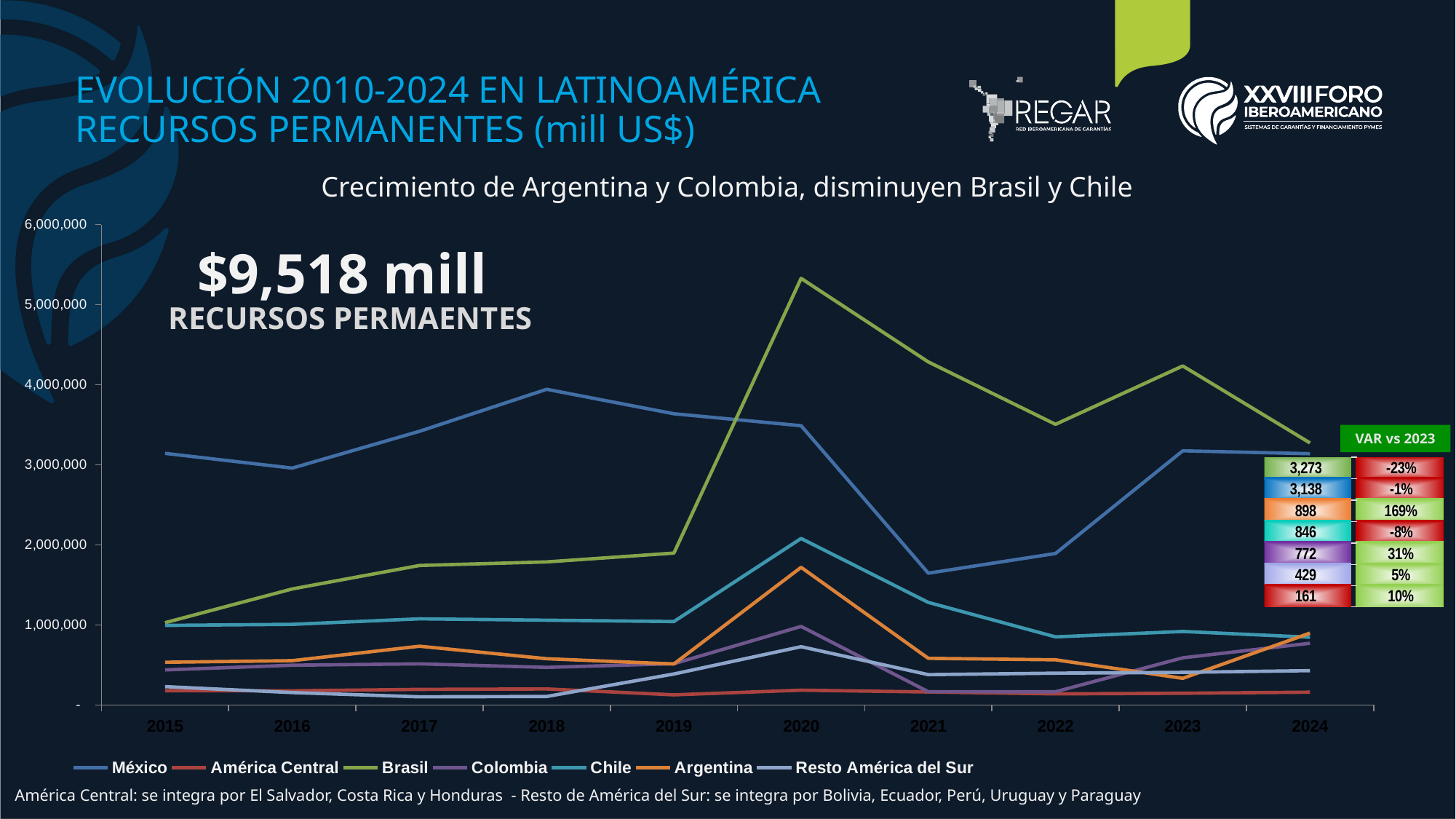
Which series has the lowest value in 2024? América Central Does the Brasil line rise or fall from 2015 to 2020? rise How many years are shown along the x axis? 10 How many series does the legend list? 7 What kind of chart is shown on the slide? line chart In 2020, which is larger: the value for Brasil or the value for México? Brasil According to the VAR vs 2023 table, what is the variation shown for the orange (Argentina) row? 169% Which series has the highest value in 2020? Brasil Is the value for Chile in 2020 greater or less than 2,000,000? greater Which series has the highest value in 2015? México Is the value for Brasil in 2020 greater or less than 5,000,000? greater